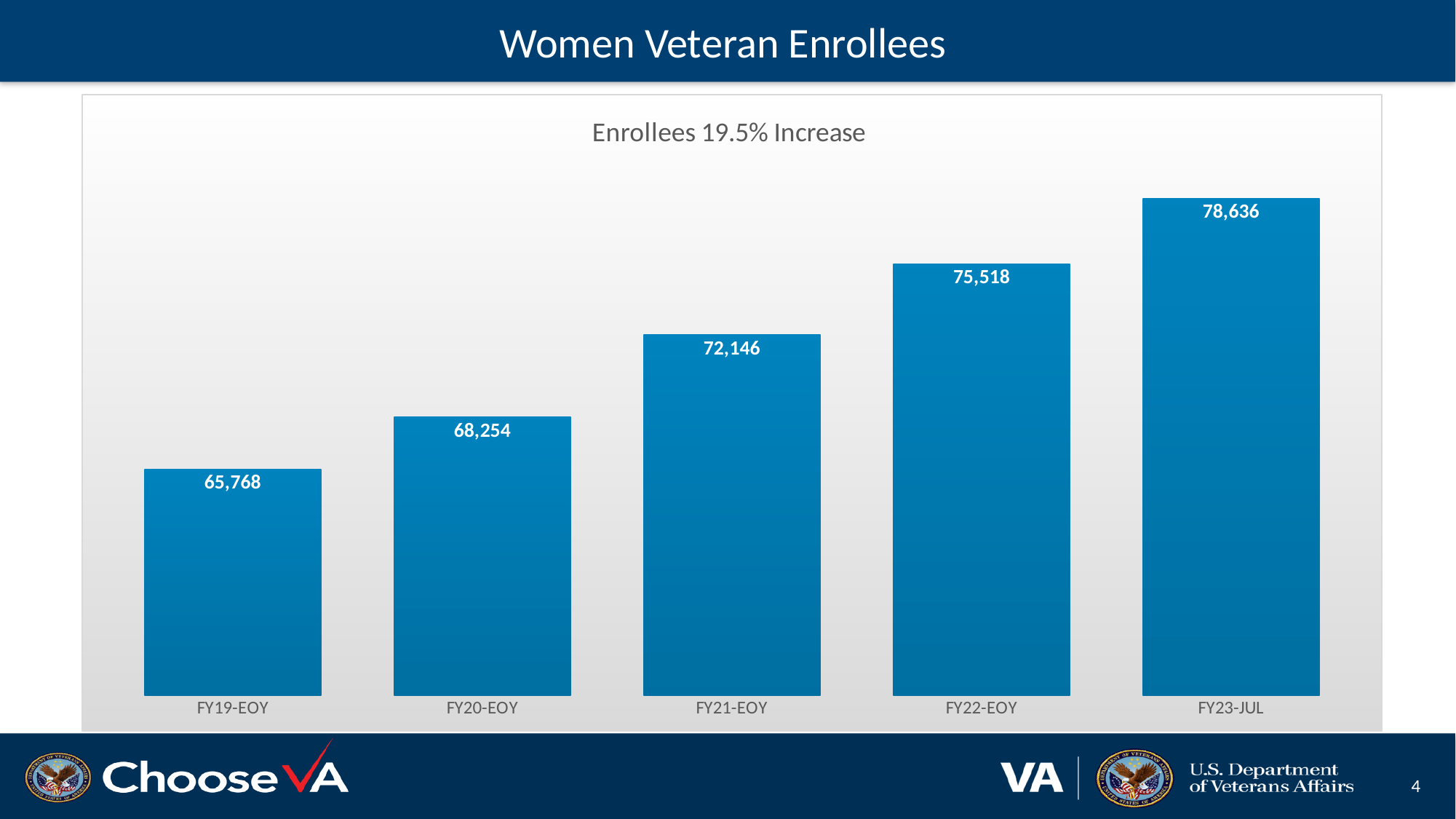
What is the value for FY19-EOY? 65,768 What is the title of the chart? Enrollees 19.5% Increase Which is larger, the value for FY20-EOY or the value for FY22-EOY? FY22-EOY How many categories are shown on the x axis? 5 What kind of chart is shown on the slide? Bar chart Do the values rise or fall from FY19-EOY to FY23-JUL? Rise Which category has the highest value? FY23-JUL What is the difference between the values for FY23-JUL and FY19-EOY? 12,868 What is the value for FY23-JUL? 78,636 What is the value for FY21-EOY? 72,146 Which category has the lowest value? FY19-EOY What is the difference between the values for FY22-EOY and FY21-EOY? 3,372